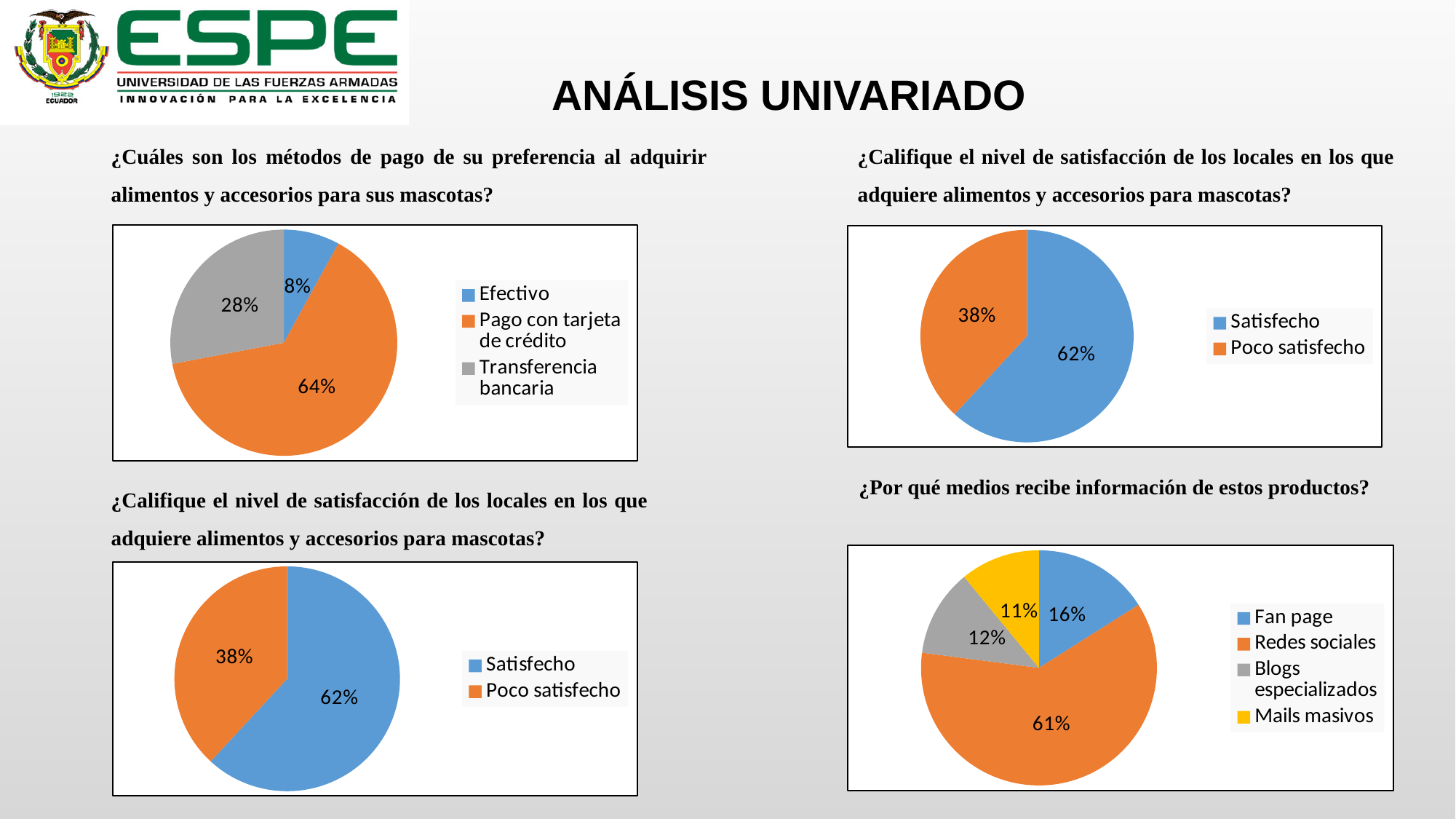
In the top-left pie chart about preferred payment methods, which category has the smallest slice? Efectivo In the top-right pie chart about satisfaction level, what share is labelled for 'Poco satisfecho'? 38% In the bottom-right pie chart about information media, which category has the largest slice? Redes sociales In the bottom-left pie chart about satisfaction level, what share is labelled for 'Satisfecho'? 62% In the top-left pie chart about preferred payment methods, what share is labelled for 'Pago con tarjeta de crédito'? 64% How many categories does the legend of the top-left pie chart about preferred payment methods list? 3 In the top-right pie chart about satisfaction level, which category is larger, 'Satisfecho' or 'Poco satisfecho'? Satisfecho What kind of chart is the bottom-left chart about satisfaction level? Pie chart In the bottom-right pie chart about information media, what is the difference between the 'Fan page' and 'Mails masivos' shares? 5% In the top-left pie chart about preferred payment methods, what is the difference between the 'Transferencia bancaria' and 'Efectivo' shares? 20% In the bottom-right pie chart about information media, what share is labelled for 'Blogs especializados'? 12% In the top-left pie chart about preferred payment methods, what share is labelled for 'Efectivo'? 8%